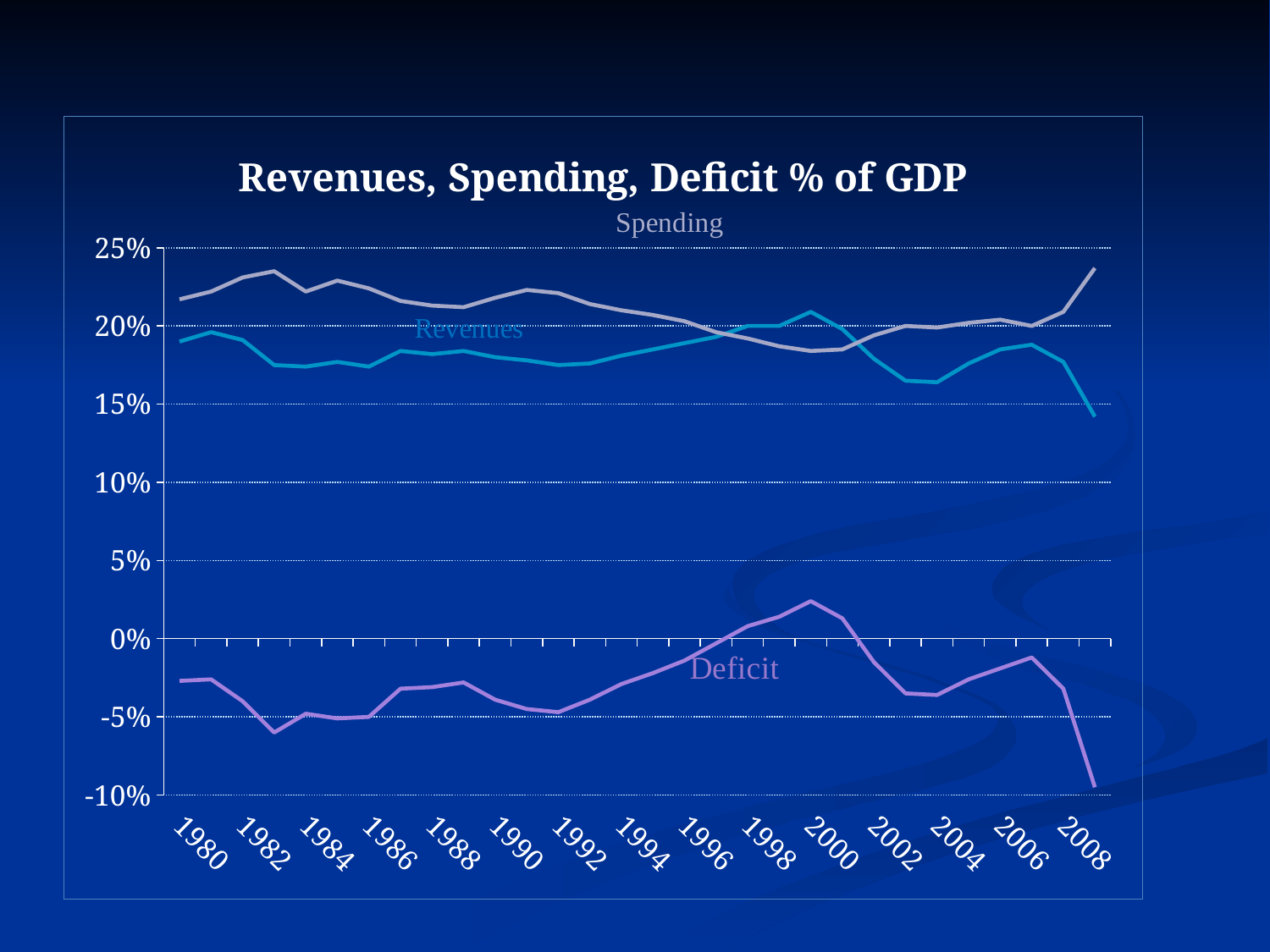
What is the title of the chart? Revenues, Spending, Deficit % of GDP Does the Revenues line rise or fall from 2006 to the right end of the chart? Fall How many data series are plotted on the chart? 3 Is the Deficit value for 1982 greater or less than -5%? greater Is the Revenues value for 1984 greater or less than 20%? less In 2000, which is higher, Revenues or Spending? Revenues Is the Deficit value for 2000 greater or less than 0%? greater In 1980, which is higher, Spending or Revenues? Spending In which year does the Deficit line reach its highest point? 2000 What kind of chart is shown on the slide? Line chart